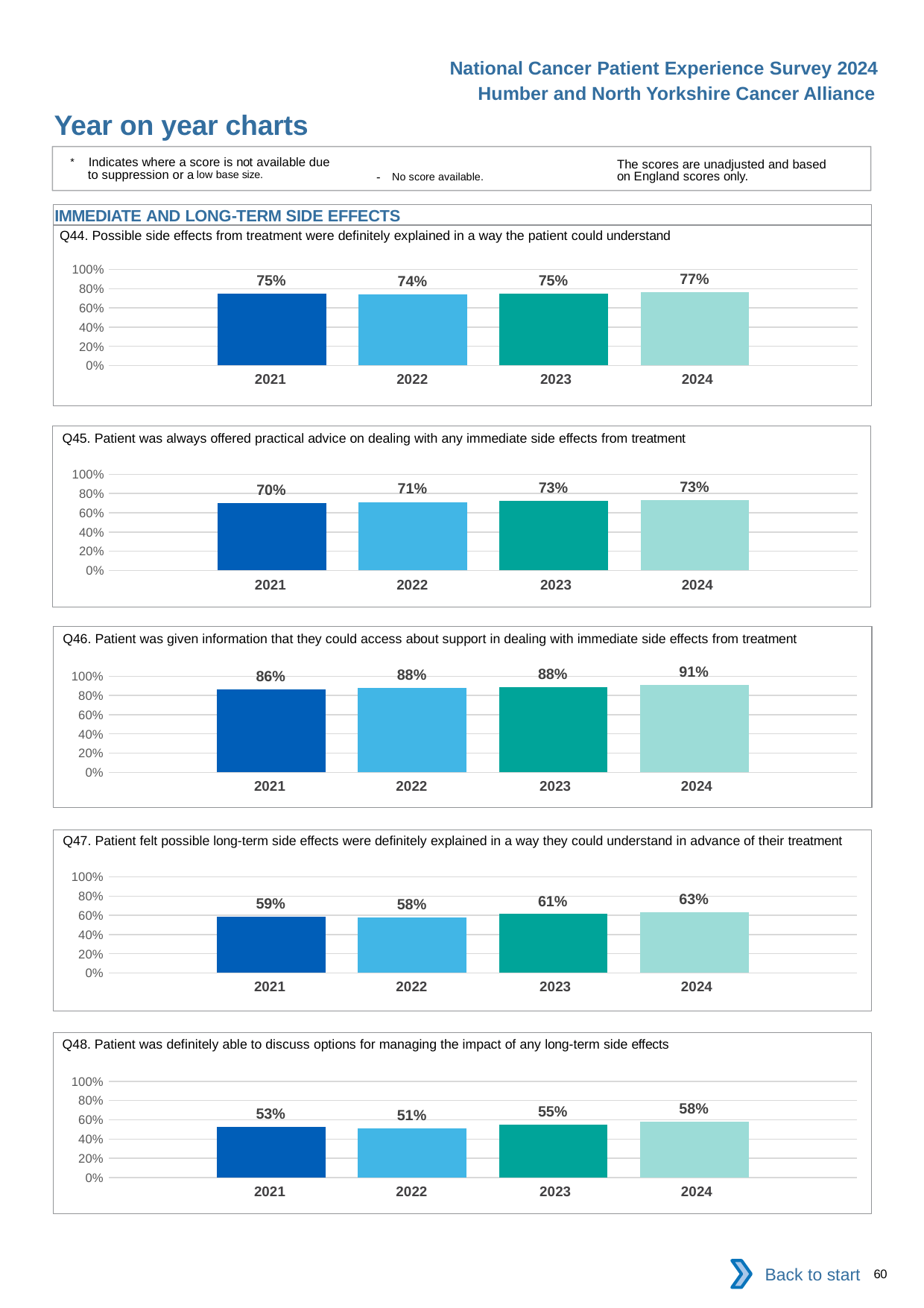
How many years are shown in the Q44 chart? 4 In the Q44 chart, what is the value for 2024? 77% In the Q48 chart, what is the value for 2022? 51% In the Q47 chart, what is the value for 2021? 59% In the Q46 chart, what is the difference between the 2024 and 2021 values? 5% What kind of chart is the Q45 chart? bar chart In the Q47 chart, which is larger, the value for 2022 or the value for 2023? 2023 In the Q48 chart, which year has the highest value? 2024 In the Q46 chart, is the value for 2024 greater or less than 80%? greater What is the section heading above the Q44 chart? IMMEDIATE AND LONG-TERM SIDE EFFECTS In the Q48 chart, what is the difference between the 2023 and 2022 values? 4% In the Q45 chart, which year has the lowest value? 2021